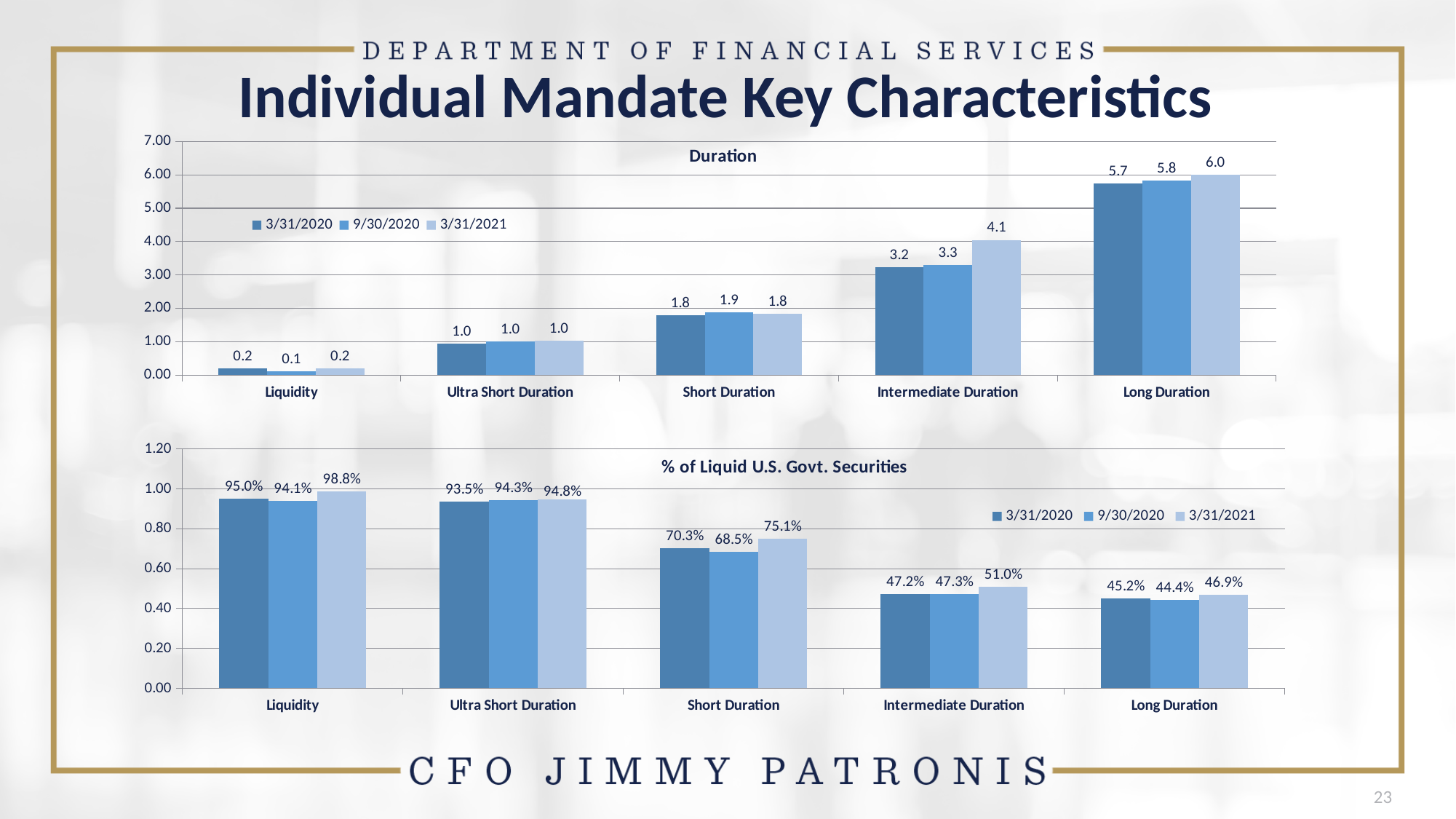
In the Duration chart, what is the difference between the 3/31/2021 and 9/30/2020 values for Intermediate Duration? 0.8 In the % of Liquid U.S. Govt. Securities chart, which category has the lowest value for 3/31/2021? Long Duration In the Duration chart, which category has the lowest value for 9/30/2020? Liquidity In the Duration chart, which category has the highest value for 3/31/2021? Long Duration In the Duration chart, how many series does the legend list? 3 In the % of Liquid U.S. Govt. Securities chart, is the 3/31/2020 value for Liquidity or for Short Duration larger? Liquidity In the % of Liquid U.S. Govt. Securities chart, what is the value for Short Duration on 3/31/2021? 75.1% In the Duration chart, what is the value for Intermediate Duration on 3/31/2020? 3.2 In the Duration chart, what is the value for Long Duration on 3/31/2021? 6.0 In the % of Liquid U.S. Govt. Securities chart, how many categories are shown on the x axis? 5 In the % of Liquid U.S. Govt. Securities chart, what is the value for Long Duration on 9/30/2020? 44.4% What kind of chart is the Duration chart? Bar chart